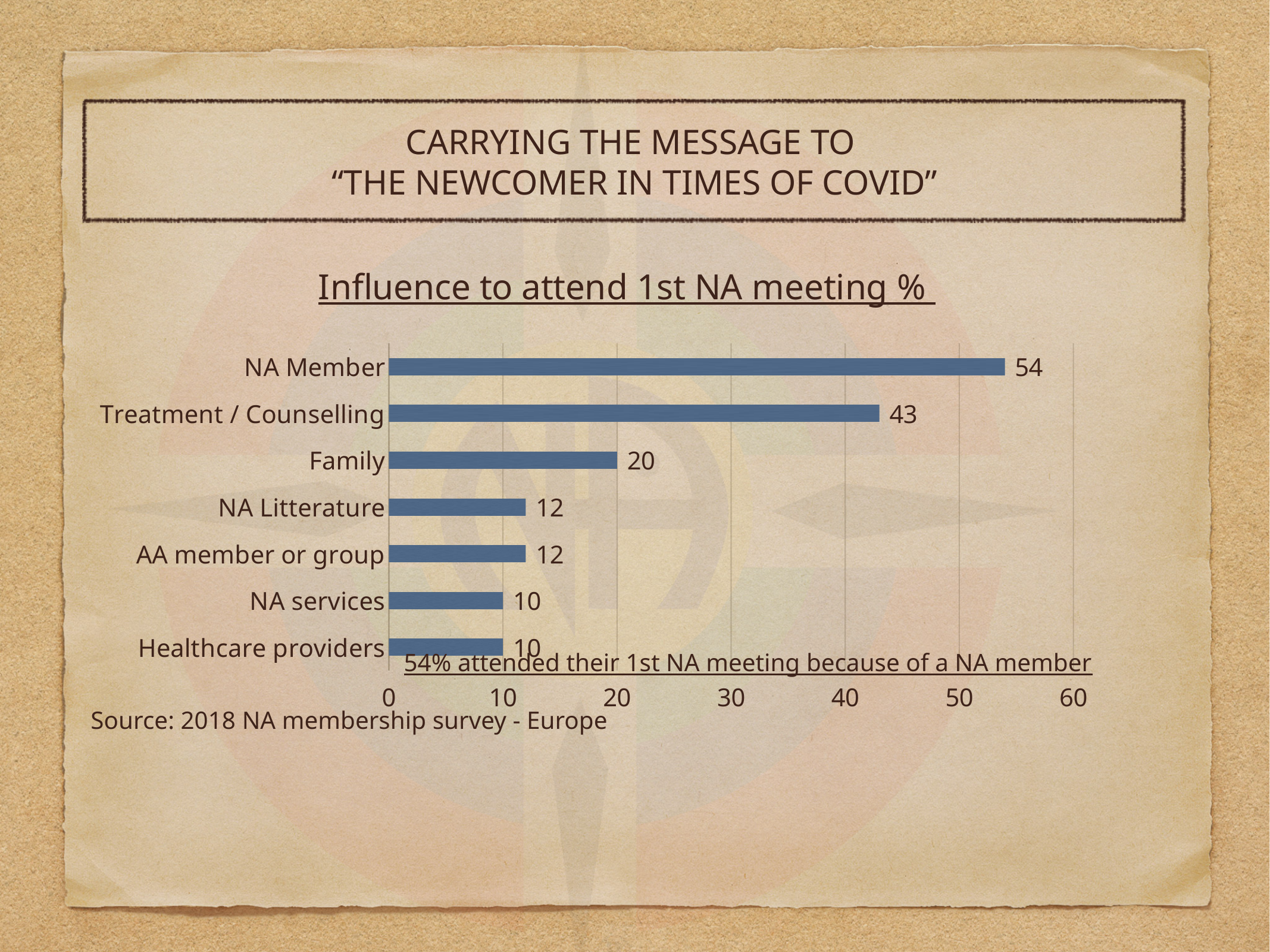
What kind of chart is shown on the slide? Bar chart What is the difference between the values for Family and NA Litterature? 8 Which is larger, the value for Family or the value for AA member or group? Family Which category has the highest value? NA Member Is the value for Treatment / Counselling greater or less than 40? greater What is the value for NA services? 10 What is the difference between the values for NA Member and Treatment / Counselling? 11 What is the value for NA Member? 54 What is the value for Treatment / Counselling? 43 What is the title of the chart? Influence to attend 1st NA meeting % How many categories are shown in the chart? 7 What is the value for Family? 20